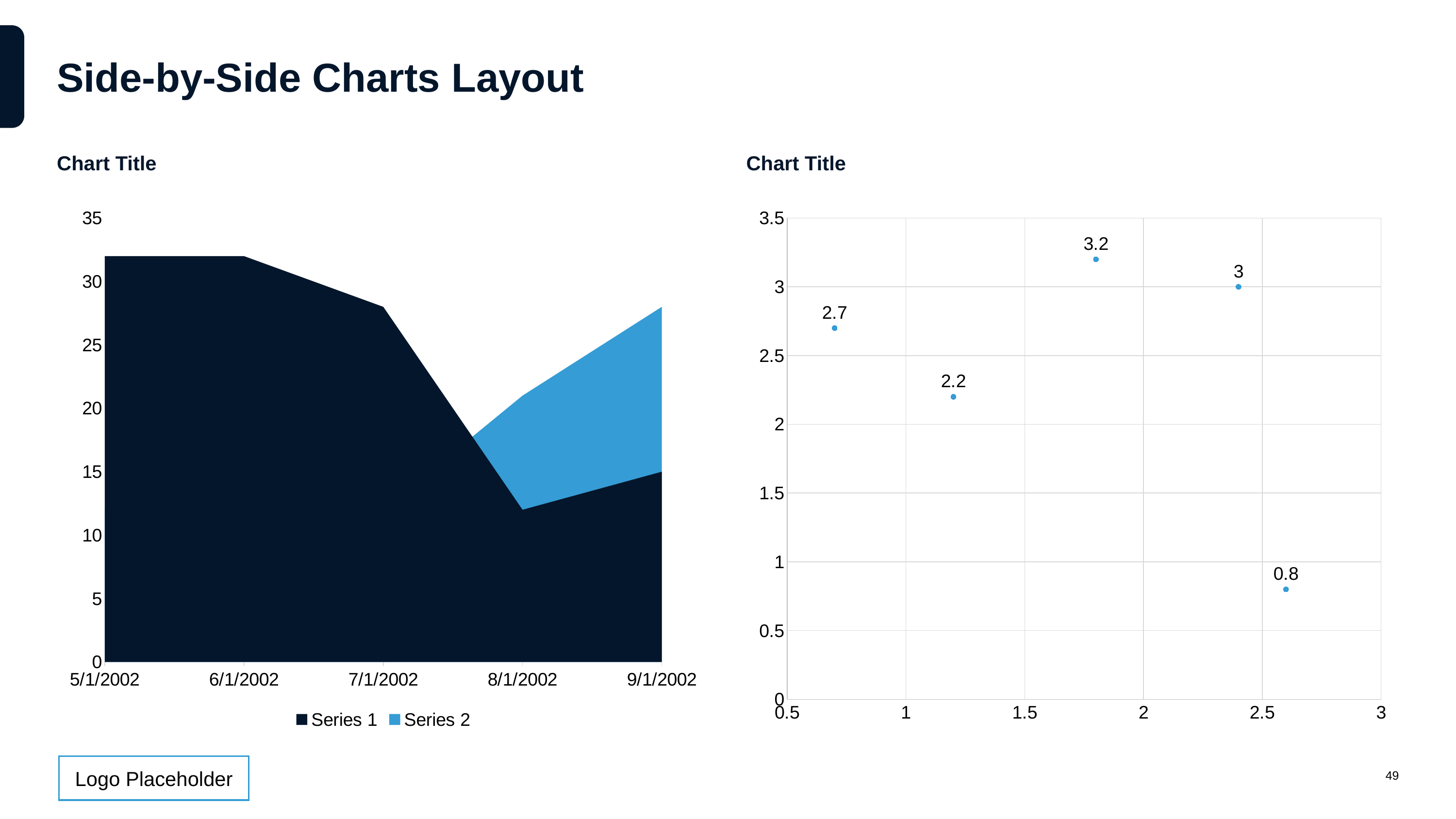
In the right chart, what is the highest labelled value? 3.2 In the left chart, is the value of Series 1 at 8/1/2002 greater or less than 15? less In the right chart, what is the lowest labelled value? 0.8 In the right chart, how many data points are plotted? 5 What kind of chart is the chart on the right of the slide? scatter chart In the left chart, how many series does the legend list? 2 What kind of chart is the chart on the left of the slide? area chart In the right chart, what is the difference between the highest point (3.2) and the lowest point (0.8)? 2.4 In the right chart, what is the value of the leftmost data point? 2.7 In the left chart, does Series 1 rise or fall from 5/1/2002 to 8/1/2002? fall In the left chart, is the value of Series 1 at 5/1/2002 greater or less than 30? greater In the left chart, how many dates are shown on the x axis? 5